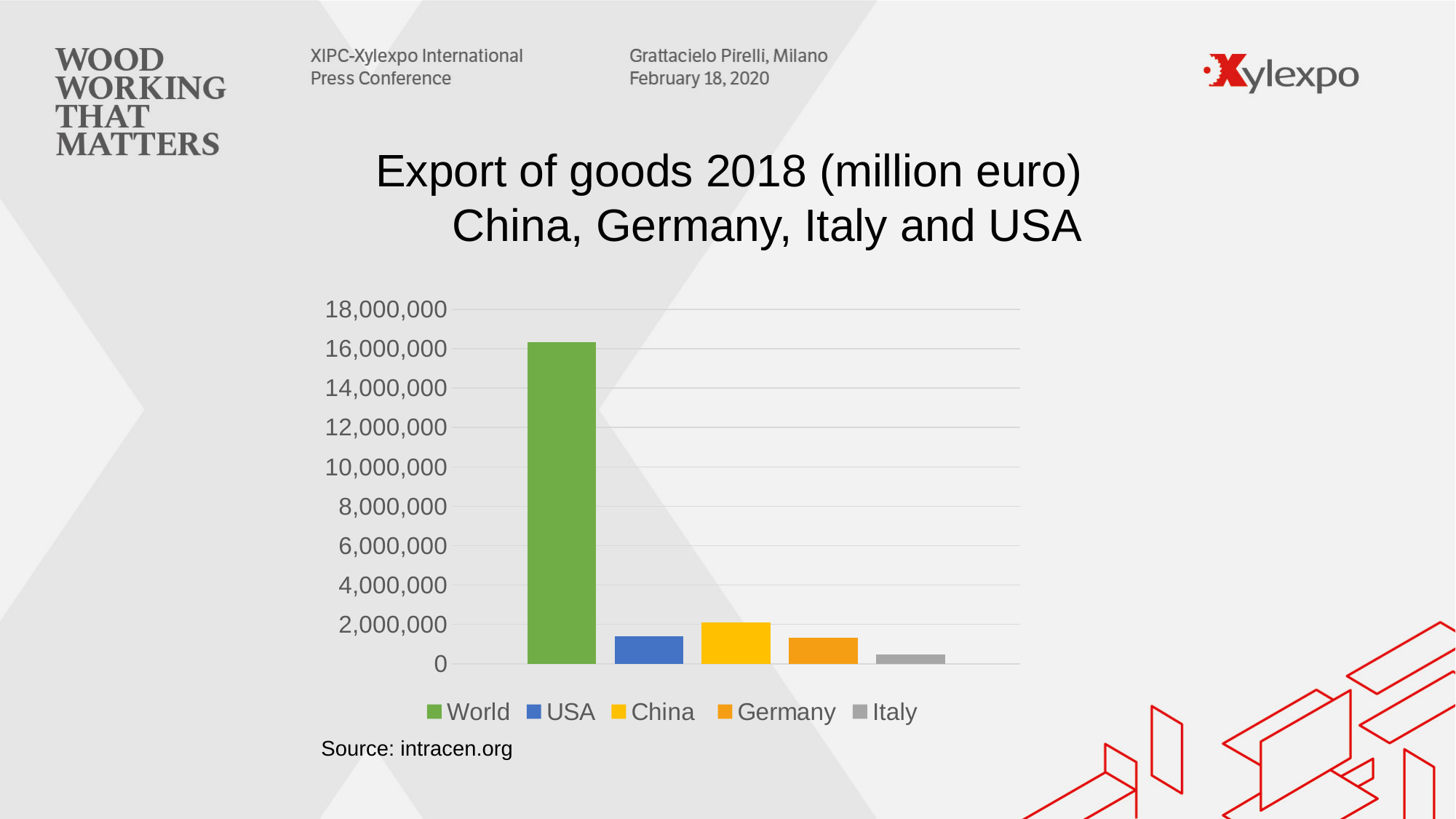
Is the value for China greater or less than 4,000,000? less Is the value for Italy greater or less than 2,000,000? less Which series has the lowest value? Italy Is the value for USA greater or less than 2,000,000? less What colour is the bar for Germany? Orange How many series does the legend list? 5 Which series has the highest value? World What kind of chart is shown on the slide? Bar chart Which is larger, the value for China or the value for USA? China What is the title of the chart? Export of goods 2018 (million euro) China, Germany, Italy and USA How many bars are plotted in the chart? 5